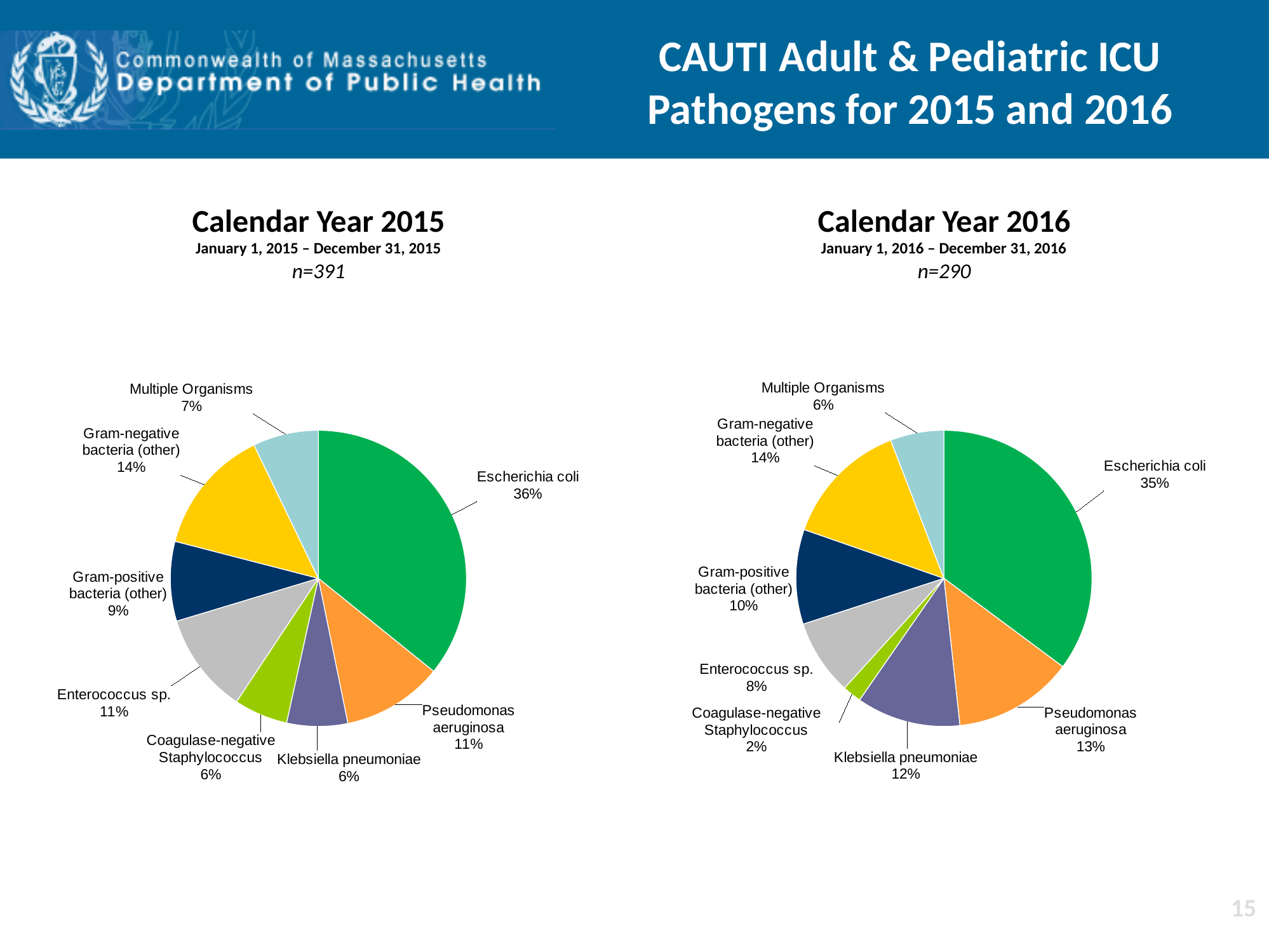
How many slices does the Calendar Year 2015 pie chart have? 8 In the Calendar Year 2016 pie chart, what share does Gram-positive bacteria (other) have? 10% In the Calendar Year 2016 pie chart, which is larger: Pseudomonas aeruginosa or Enterococcus sp.? Pseudomonas aeruginosa In the Calendar Year 2015 pie chart, what share does Escherichia coli have? 36% What is the sample size (n) shown for the Calendar Year 2016 chart? n=290 What is the sample size (n) shown for the Calendar Year 2015 chart? n=391 In the Calendar Year 2016 pie chart, which pathogen category has the smallest slice? Coagulase-negative Staphylococcus In the Calendar Year 2015 pie chart, which pathogen category has the largest slice? Escherichia coli In the Calendar Year 2015 pie chart, what is the difference in percentage points between Gram-negative bacteria (other) and Gram-positive bacteria (other)? 5 percentage points In the Calendar Year 2016 pie chart, what share does Klebsiella pneumoniae have? 12% What type of chart is used for the Calendar Year 2016 data? Pie chart